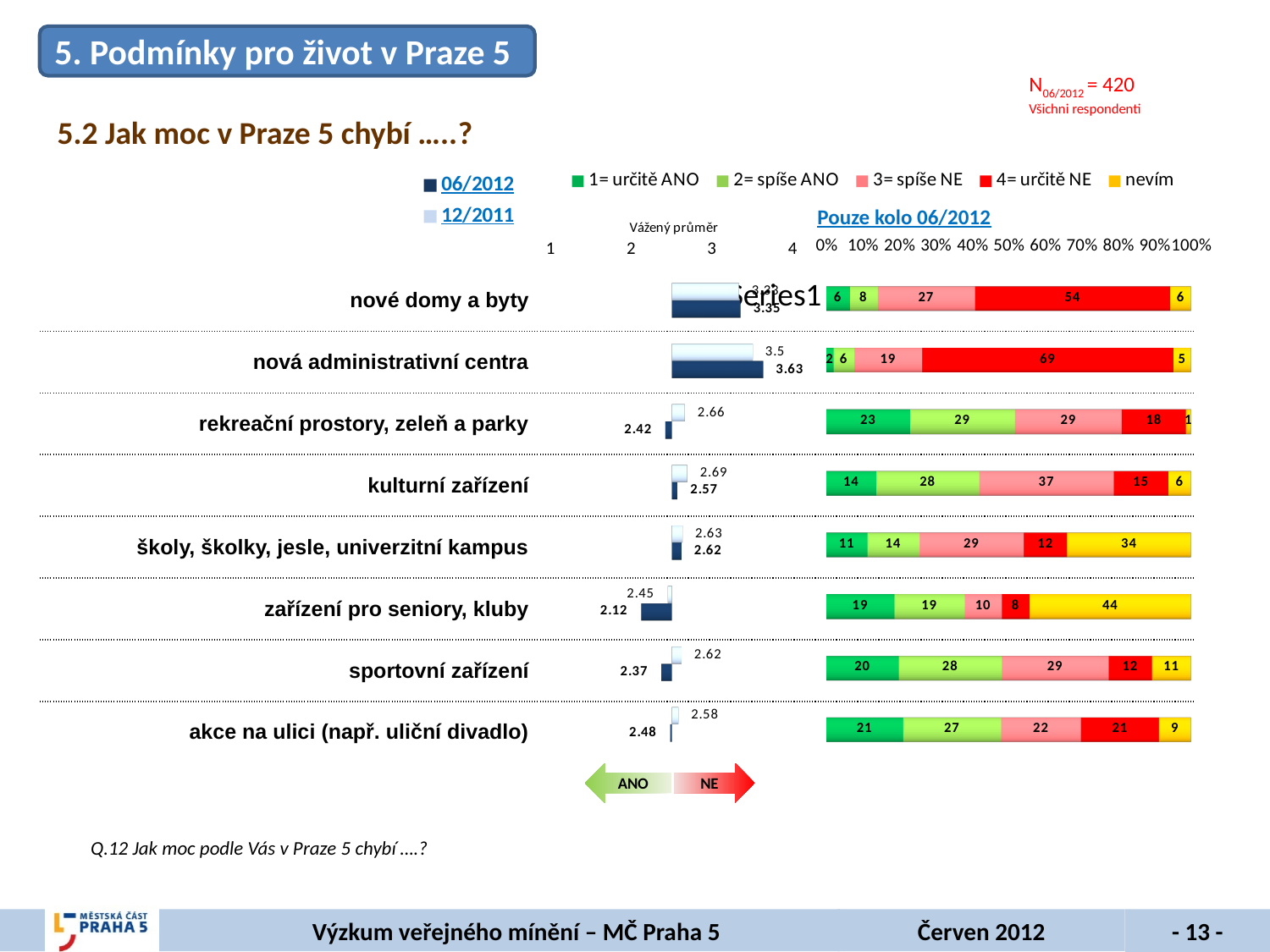
In the 'Vážený průměr' chart, what is the 12/2011 value for 'kulturní zařízení'? 2.69 In the 'Pouze kolo 06/2012' stacked bar chart, what is the value of '1= určitě ANO' for 'rekreační prostory, zeleň a parky'? 23 In the 'Pouze kolo 06/2012' stacked bar chart, what is the value of '4= určitě NE' for 'nová administrativní centra'? 69 What type of chart is the 'Pouze kolo 06/2012' chart? Stacked bar chart In the 'Vážený průměr' chart, which category has the lowest 06/2012 value? zařízení pro seniory, kluby How many series does the legend of the 'Pouze kolo 06/2012' stacked bar chart list? 5 In the 'Pouze kolo 06/2012' stacked bar chart, what is the value of 'nevím' for 'zařízení pro seniory, kluby'? 44 In the 'Pouze kolo 06/2012' stacked bar chart, which is larger for 'kulturní zařízení': '2= spíše ANO' or '3= spíše NE'? 3= spíše NE In the 'Pouze kolo 06/2012' stacked bar chart, which category has the highest '4= určitě NE' value? nová administrativní centra How many categories are shown in the 'Vážený průměr' chart? 8 In the 'Vážený průměr' chart, what is the 06/2012 value for 'nová administrativní centra'? 3.63 In the 'Vážený průměr' chart, what is the difference between the 12/2011 and 06/2012 values for 'zařízení pro seniory, kluby'? 0.33